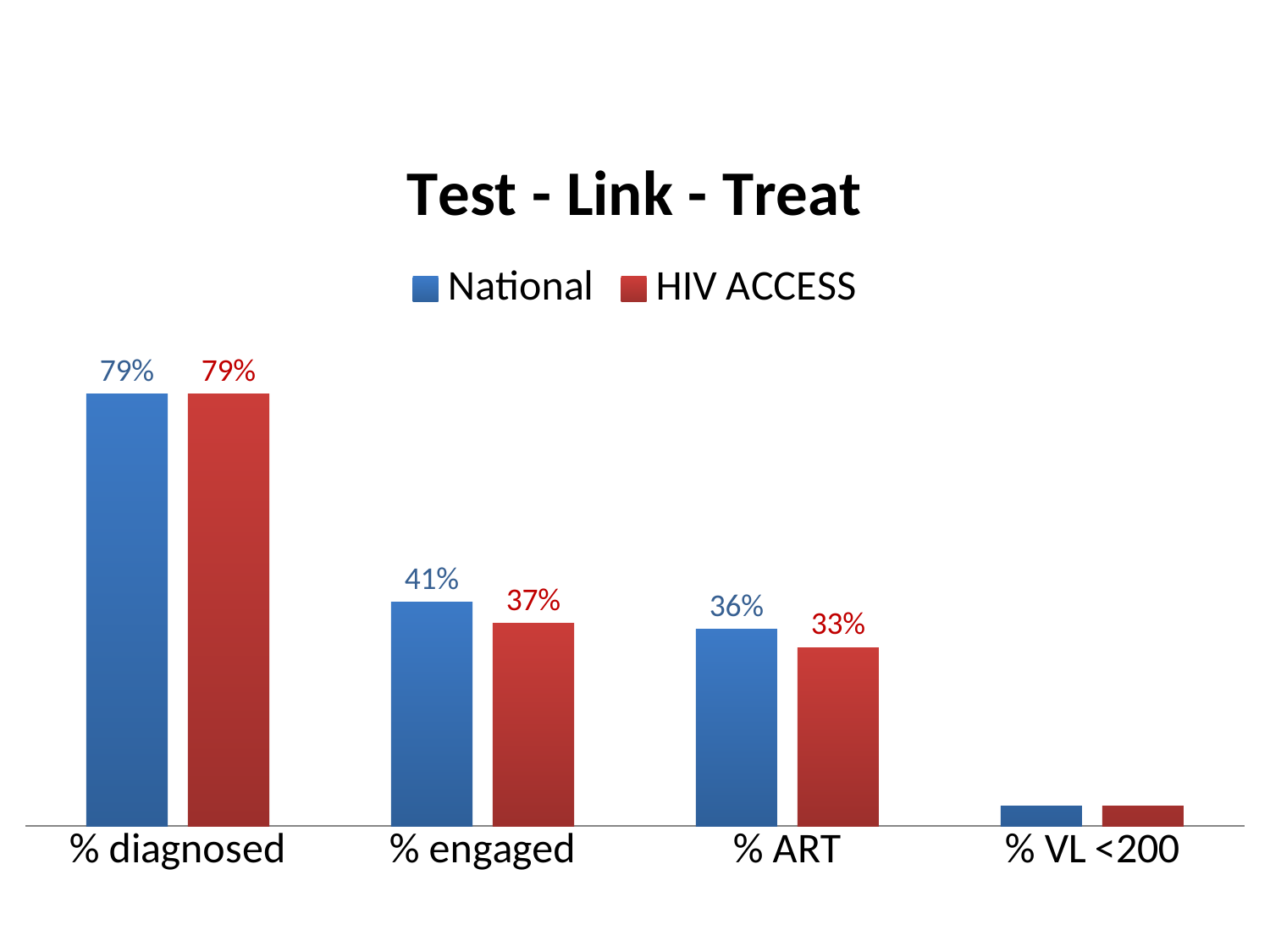
How many categories are shown on the x axis? 4 What is the HIV ACCESS value for % engaged? 37% What is the National value for % ART? 36% What is the difference between the National and HIV ACCESS values for % engaged? 4% What is the National value for % diagnosed? 79% What is the title of the chart? Test - Link - Treat What is the HIV ACCESS value for % ART? 33% How many series does the legend list? 2 Which category has the lowest HIV ACCESS value? % VL <200 Which is larger for % ART, the National value or the HIV ACCESS value? National Which category has the highest National value? % diagnosed What kind of chart is this? Bar chart